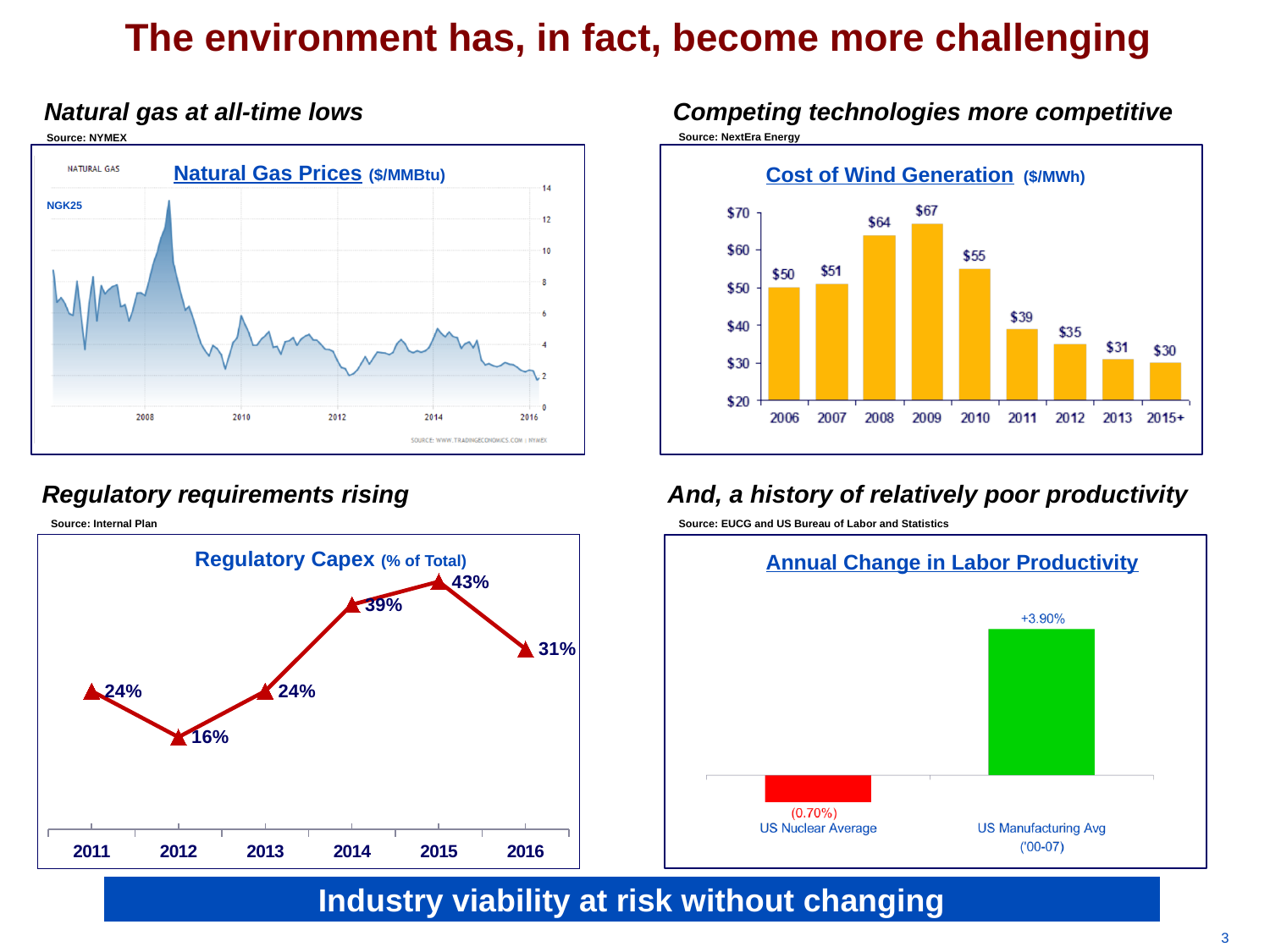
In the Cost of Wind Generation chart, what is the value for 2009? $67 In the Cost of Wind Generation chart, is the value for 2010 larger than the value for 2012? Yes, 2010 ($55) In the Regulatory Capex chart, what is the value for 2014? 39% In the Annual Change in Labor Productivity chart, which category has the higher value? US Manufacturing Avg ('00-07) In the Regulatory Capex chart, which year has the highest value? 2015 In the Natural Gas Prices chart, is the value at 2016 greater or less than 4? less In the Cost of Wind Generation chart, which year has the lowest cost? 2015+ In the Cost of Wind Generation chart, what is the difference between the 2008 and 2011 values? $25 In the Annual Change in Labor Productivity chart, what is the value for US Nuclear Average? (0.70%) What kind of chart is the Regulatory Capex chart? Line chart How many categories are shown on the x axis of the Cost of Wind Generation chart? 9 In the Regulatory Capex chart, what is the difference between the 2015 and 2016 values? 12%